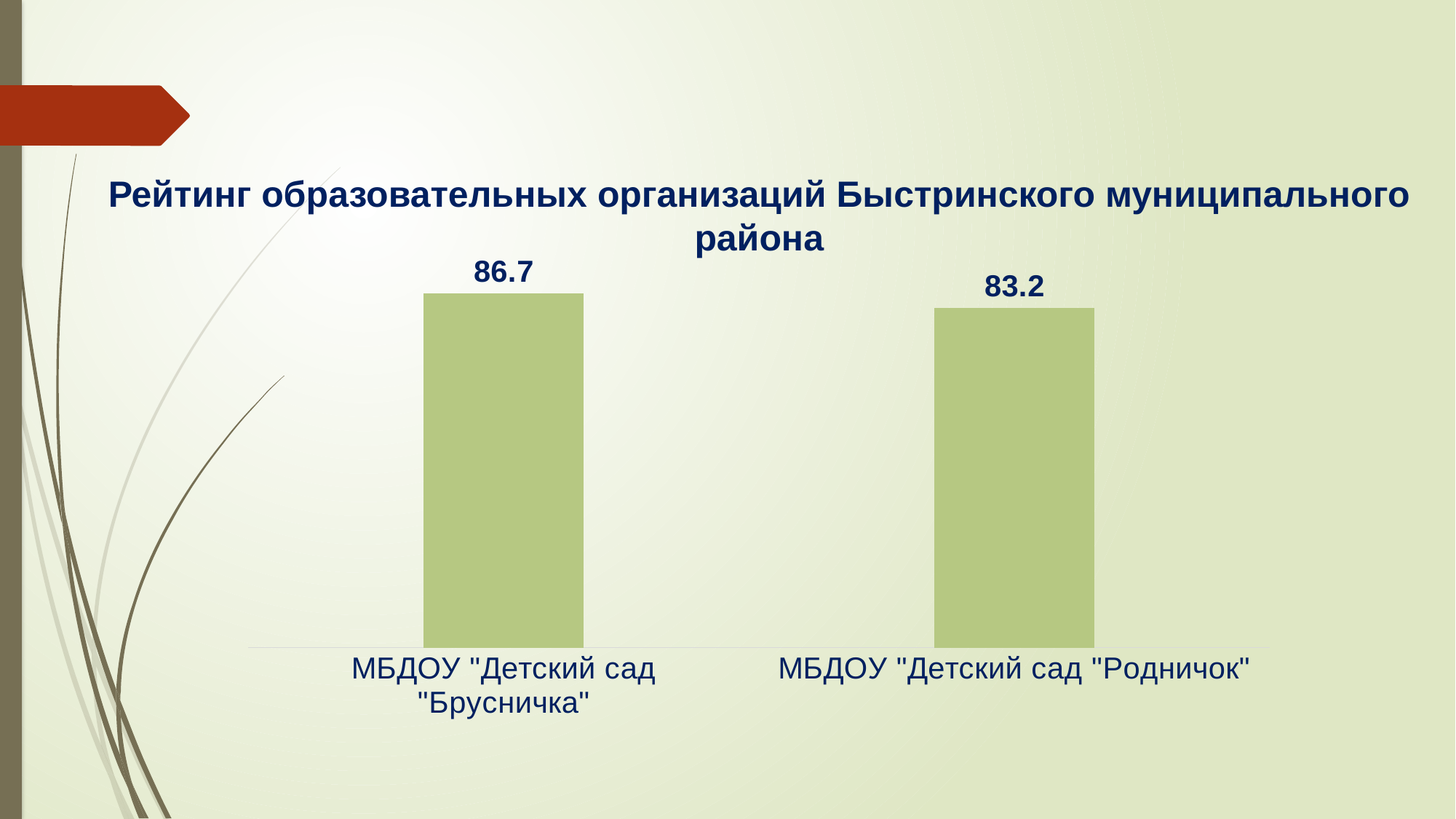
Which organisation has the highest value? МБДОУ "Детский сад "Брусничка" Which is larger, the value for МБДОУ "Детский сад "Брусничка" or for МБДОУ "Детский сад "Родничок"? МБДОУ "Детский сад "Брусничка" Which organisation has the lowest value? МБДОУ "Детский сад "Родничок" What kind of chart is shown on the slide? Bar chart What colour are the bars in the chart? Green What is the title of the chart? Рейтинг образовательных организаций Быстринского муниципального района What is the value for МБДОУ "Детский сад "Родничок"? 83.2 What is the value for МБДОУ "Детский сад "Брусничка"? 86.7 Do the values rise or fall from left to right across the chart? Fall What is the difference between the values for МБДОУ "Детский сад "Брусничка" and МБДОУ "Детский сад "Родничок"? 3.5 How many organisations are shown in the chart? 2